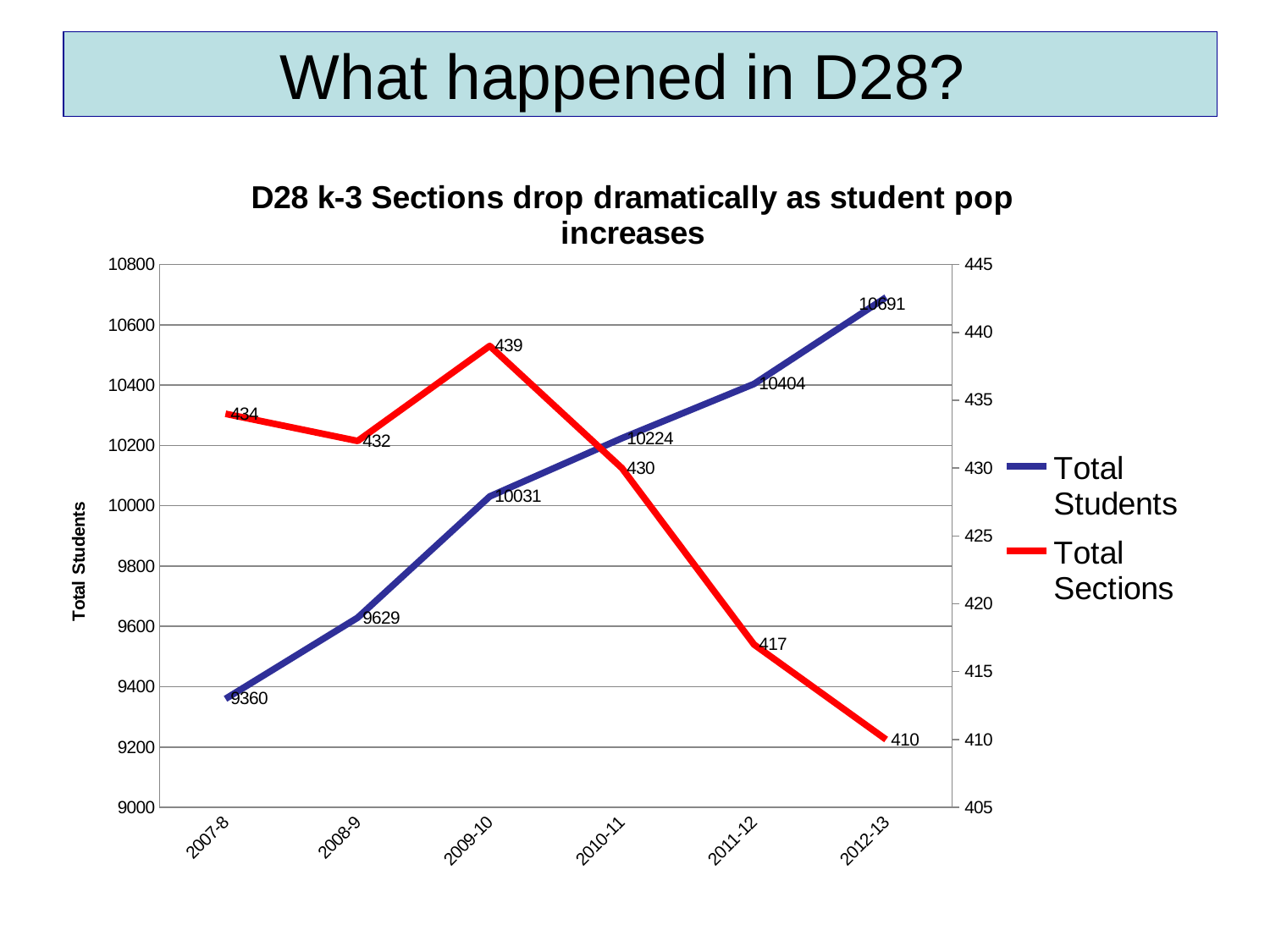
What is the value of Total Students for 2010-11? 10224 What is the value of Total Sections for 2009-10? 439 In which year is Total Sections highest? 2009-10 In which year is Total Sections lowest? 2012-13 What is the value of Total Students for 2007-8? 9360 How many series does the legend list? 2 How many school years are plotted along the x axis? 6 Is the value of Total Students for 2012-13 greater or less than 10600? greater What kind of chart is shown on the slide? line chart What is the title of the chart? D28 k-3 Sections drop dramatically as student pop increases Do the Total Students values rise or fall from 2007-8 to 2012-13? rise What is the difference between Total Sections in 2007-8 and in 2012-13? 24